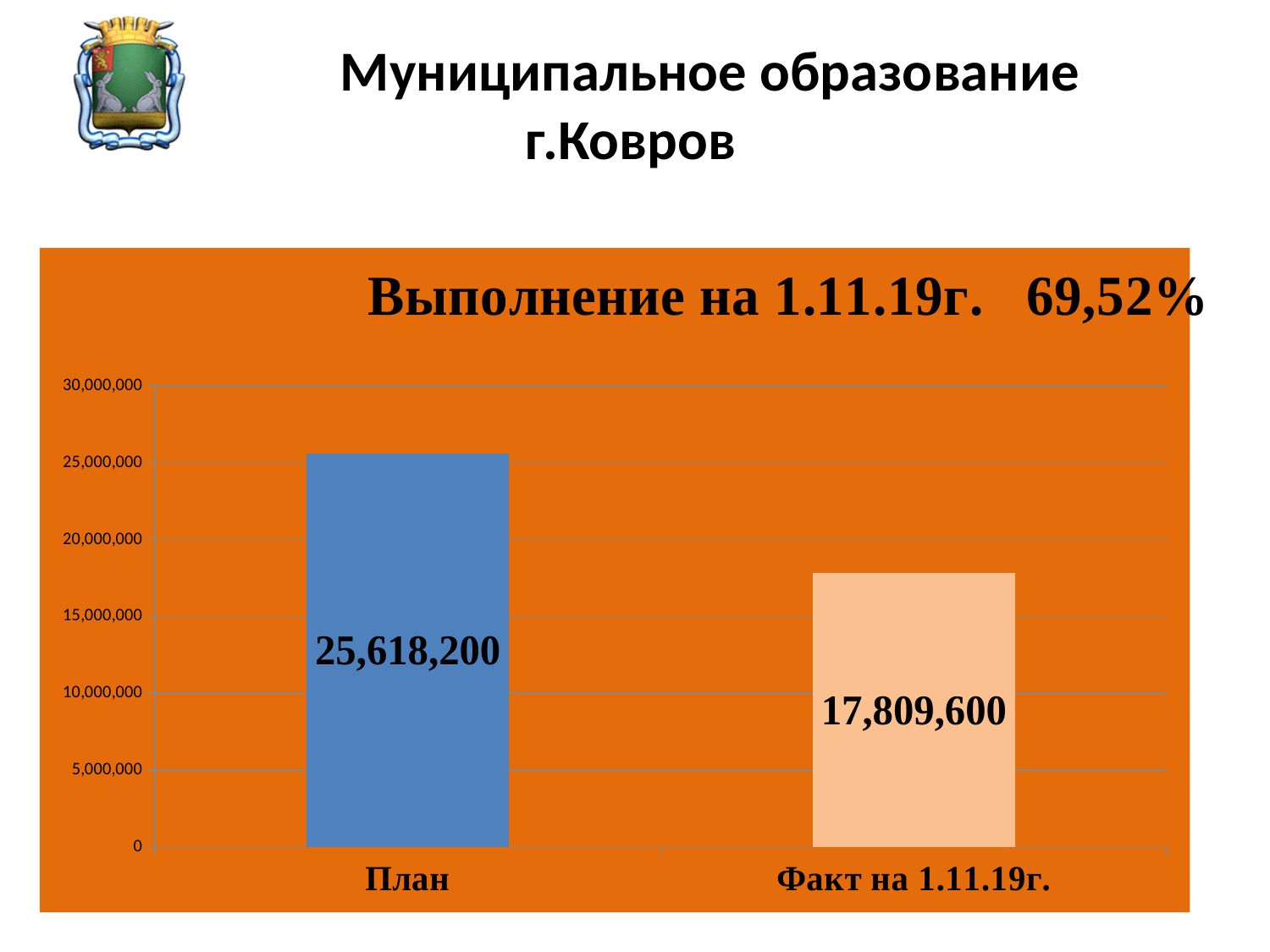
What kind of chart is shown on the slide? bar chart Which category has the highest value? План Is the value for План greater or less than 25,000,000? greater What is the title of the chart? Выполнение на 1.11.19г. 69,52% What is the value for Факт на 1.11.19г.? 17,809,600 Which is larger, the value for План or the value for Факт на 1.11.19г.? План Is the value for Факт на 1.11.19г. greater or less than 20,000,000? less What is the value for План? 25,618,200 How many categories are shown on the chart? 2 What is the highest value shown on the vertical axis? 30,000,000 What is the difference between the value for План and the value for Факт на 1.11.19г.? 7,808,600 Which category has the lowest value? Факт на 1.11.19г.